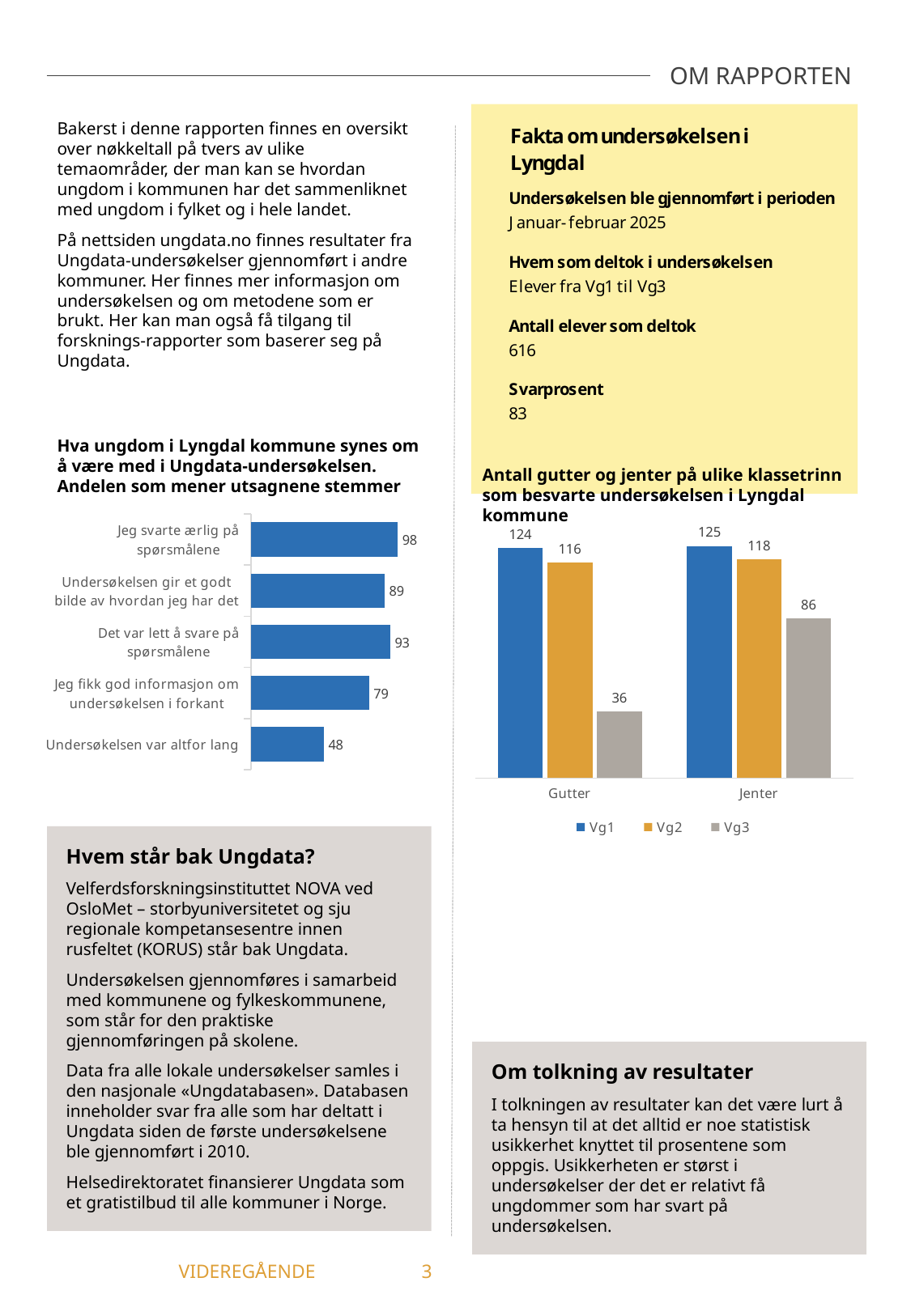
In the chart 'Antall gutter og jenter på ulike klassetrinn som besvarte undersøkelsen i Lyngdal kommune', what is the value for Vg2 among Jenter? 118 In the chart 'Hva ungdom i Lyngdal kommune synes om å være med i Ungdata-undersøkelsen', which statement has the lowest value? Undersøkelsen var altfor lang In the chart 'Hva ungdom i Lyngdal kommune synes om å være med i Ungdata-undersøkelsen', what is the difference between 'Det var lett å svare på spørsmålene' and 'Jeg fikk god informasjon om undersøkelsen i forkant'? 14 In the chart 'Hva ungdom i Lyngdal kommune synes om å være med i Ungdata-undersøkelsen', how many statements are shown? 5 In the chart 'Antall gutter og jenter på ulike klassetrinn som besvarte undersøkelsen i Lyngdal kommune', which bar has the highest value? Vg1 for Jenter In the chart 'Antall gutter og jenter på ulike klassetrinn som besvarte undersøkelsen i Lyngdal kommune', how many series does the legend list? 3 What kind of chart is 'Hva ungdom i Lyngdal kommune synes om å være med i Ungdata-undersøkelsen'? Bar chart In the chart 'Hva ungdom i Lyngdal kommune synes om å være med i Ungdata-undersøkelsen', which is larger: 'Undersøkelsen gir et godt bilde av hvordan jeg har det' or 'Det var lett å svare på spørsmålene'? Det var lett å svare på spørsmålene In the chart 'Hva ungdom i Lyngdal kommune synes om å være med i Ungdata-undersøkelsen', what is the value for 'Jeg svarte ærlig på spørsmålene'? 98 In the chart 'Antall gutter og jenter på ulike klassetrinn som besvarte undersøkelsen i Lyngdal kommune', what is the value for Vg3 among Gutter? 36 In the chart 'Antall gutter og jenter på ulike klassetrinn som besvarte undersøkelsen i Lyngdal kommune', what colour are the Vg2 bars? Orange In the chart 'Antall gutter og jenter på ulike klassetrinn som besvarte undersøkelsen i Lyngdal kommune', what is the difference between Vg3 for Jenter and Vg3 for Gutter? 50